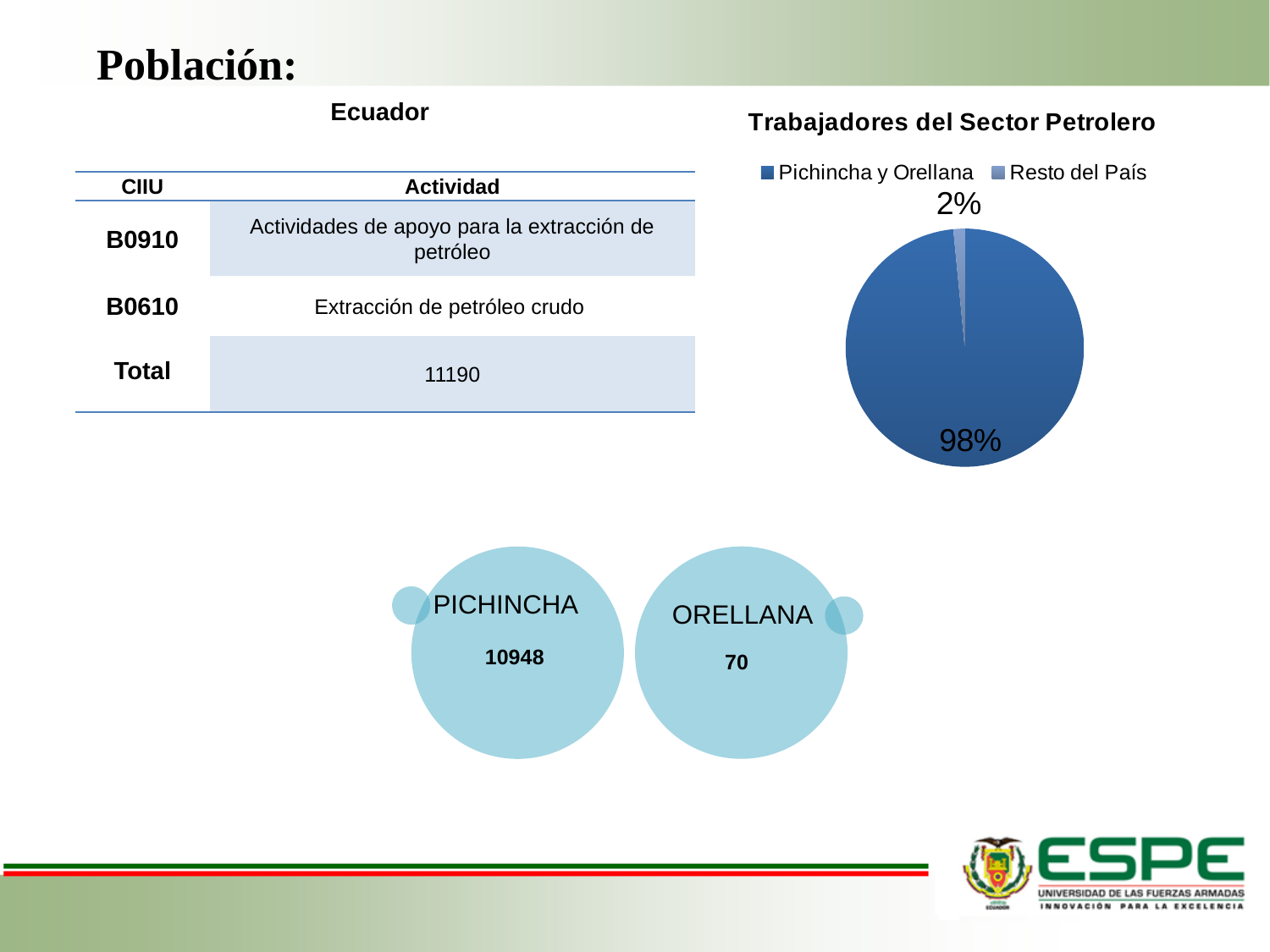
In the pie chart, which is larger: Pichincha y Orellana or Resto del País? Pichincha y Orellana How many slices does the pie chart have? 2 Which legend entry of the pie chart is shown in dark blue? Pichincha y Orellana Which slice of the pie chart is the largest? Pichincha y Orellana What is the title of the pie chart? Trabajadores del Sector Petrolero What share of the pie does the Pichincha y Orellana slice represent? 98% What kind of chart is shown under the title "Trabajadores del Sector Petrolero"? pie chart How many entries does the legend of the pie chart list? 2 In the pie chart, what share is labelled for Resto del País? 2% Which slice of the pie chart is the smallest? Resto del País In the pie chart, what share is labelled for Pichincha y Orellana? 98% What is the difference in percentage points between the Pichincha y Orellana slice and the Resto del País slice? 96 percentage points